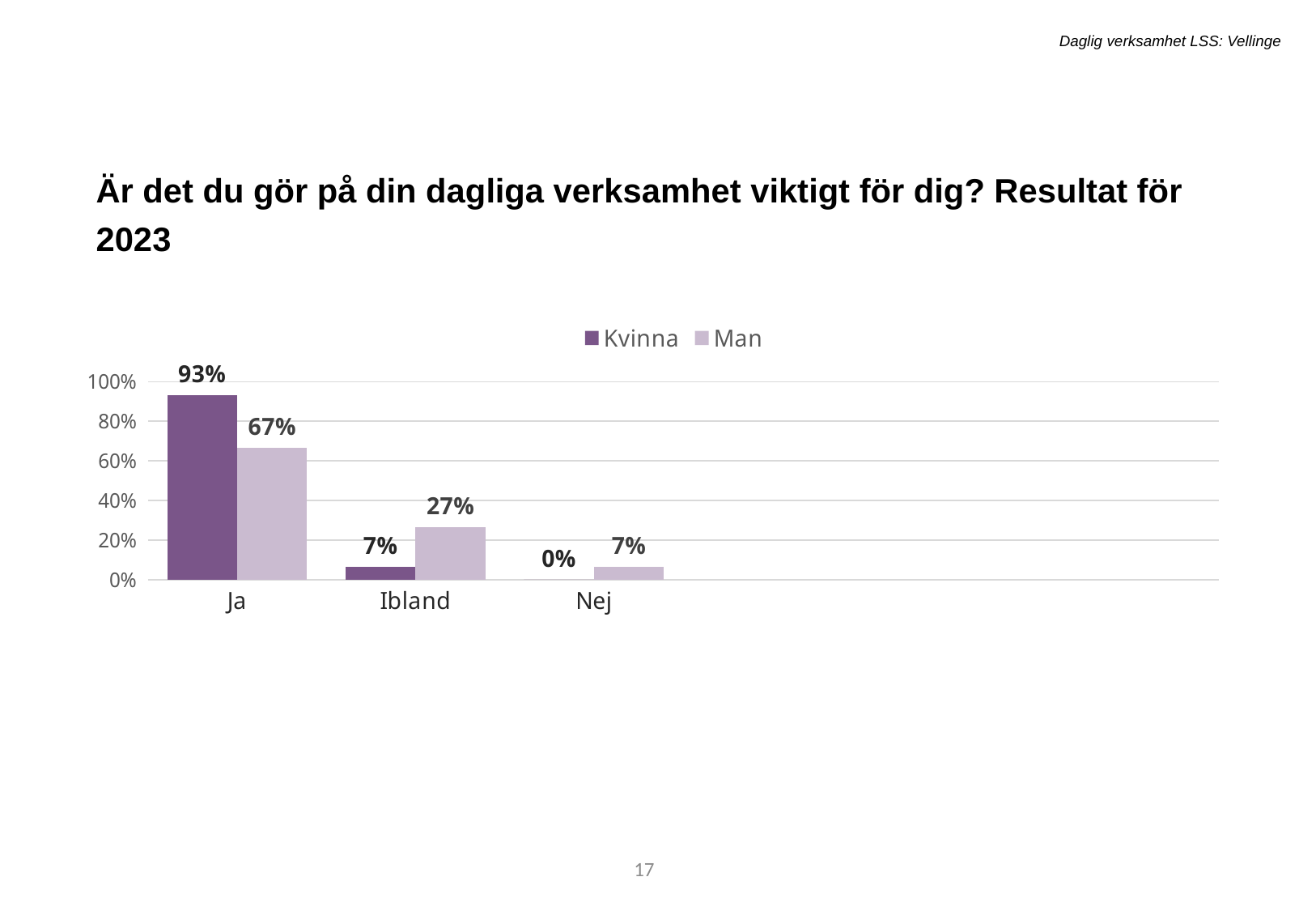
Which category has the lowest value for the Kvinna series? Nej What is the difference between the Kvinna and Man values in the Ja category? 26% How many series does the legend list? 2 What kind of chart is shown on the slide? Bar chart What is the value for Kvinna in the Nej category? 0% In the Ibland category, which series has the larger value, Kvinna or Man? Man Which category has the highest value for the Man series? Ja What is the value for Man in the Ja category? 67% What is the value for Kvinna in the Ja category? 93% What is the value for Man in the Ibland category? 27% How many categories are shown on the x axis? 3 Which series is shown in the darker purple colour? Kvinna